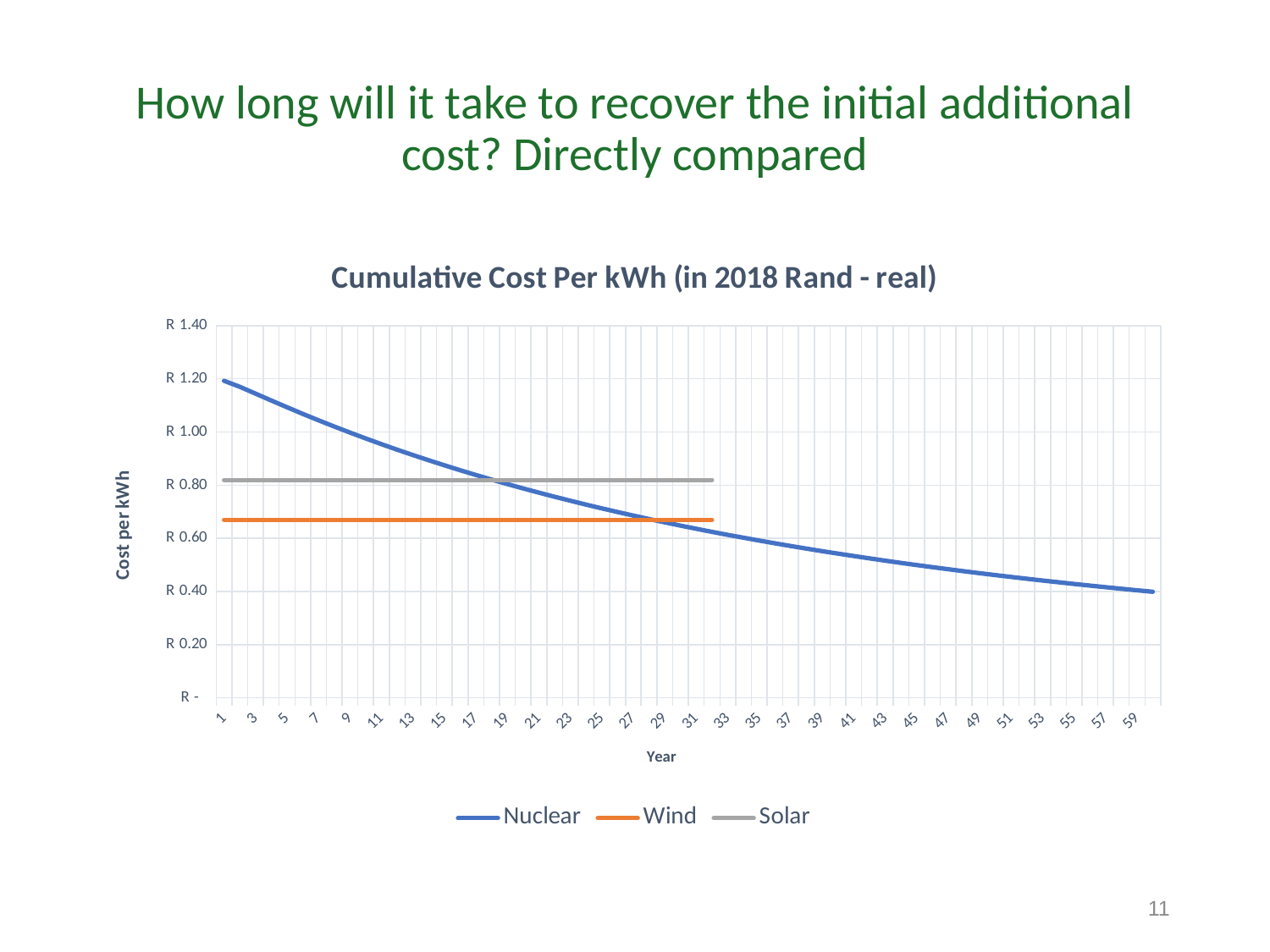
Is the Nuclear value at year 1 greater or less than R 1.00? greater Which series is shown in orange in the legend? Wind How many series does the legend list? 3 Is the Wind value greater or less than R 0.80? less Which series has the higher value, Solar or Wind? Solar What is the title of the chart? Cumulative Cost Per kWh (in 2018 Rand - real) What kind of chart is shown on the slide? Line chart Is the Nuclear value at year 59 greater or less than R 0.60? less Does the Nuclear line rise or fall as the year increases? Fall At year 1, which series has the highest cost per kWh? Nuclear